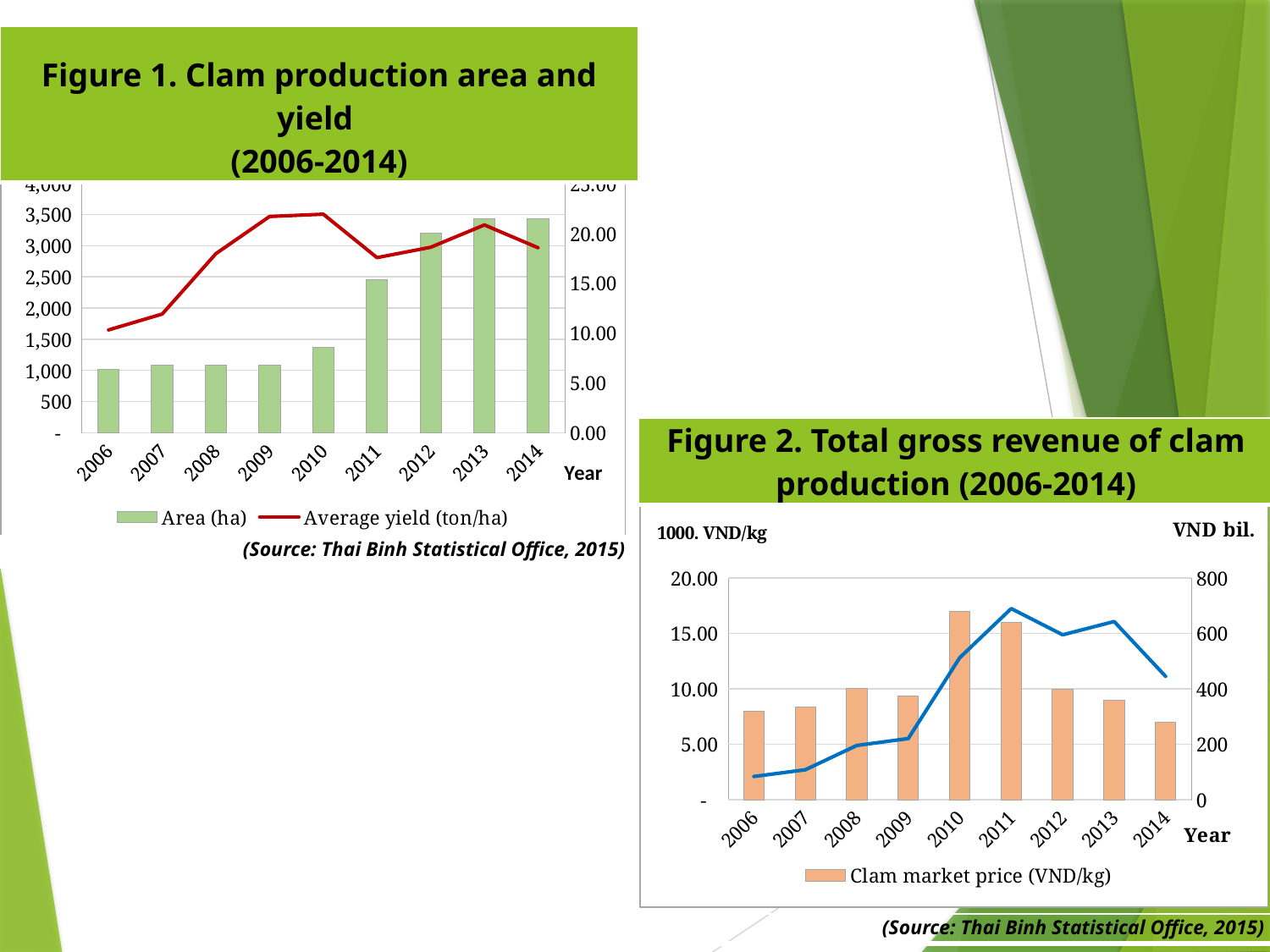
In Figure 1, which series is drawn as a line? Average yield (ton/ha) In Figure 2, how many series does the legend list? 1 In Figure 1, is the Area (ha) value for 2006 greater or less than 1,500? less In Figure 1, is the Average yield for 2006 greater or less than 15.00? less In Figure 2, which year has the lowest Clam market price? 2014 In Figure 1, is the Area (ha) value for 2011 greater or less than 2,000? greater In Figure 1, how many series does the legend list? 2 In Figure 2, what kind of chart is used for the Clam market price series? bar chart In Figure 1, how many years are shown on the x axis? 9 In Figure 1, which is larger, the Area (ha) in 2012 or in 2010? 2012 In Figure 2, which year has the highest Clam market price? 2010